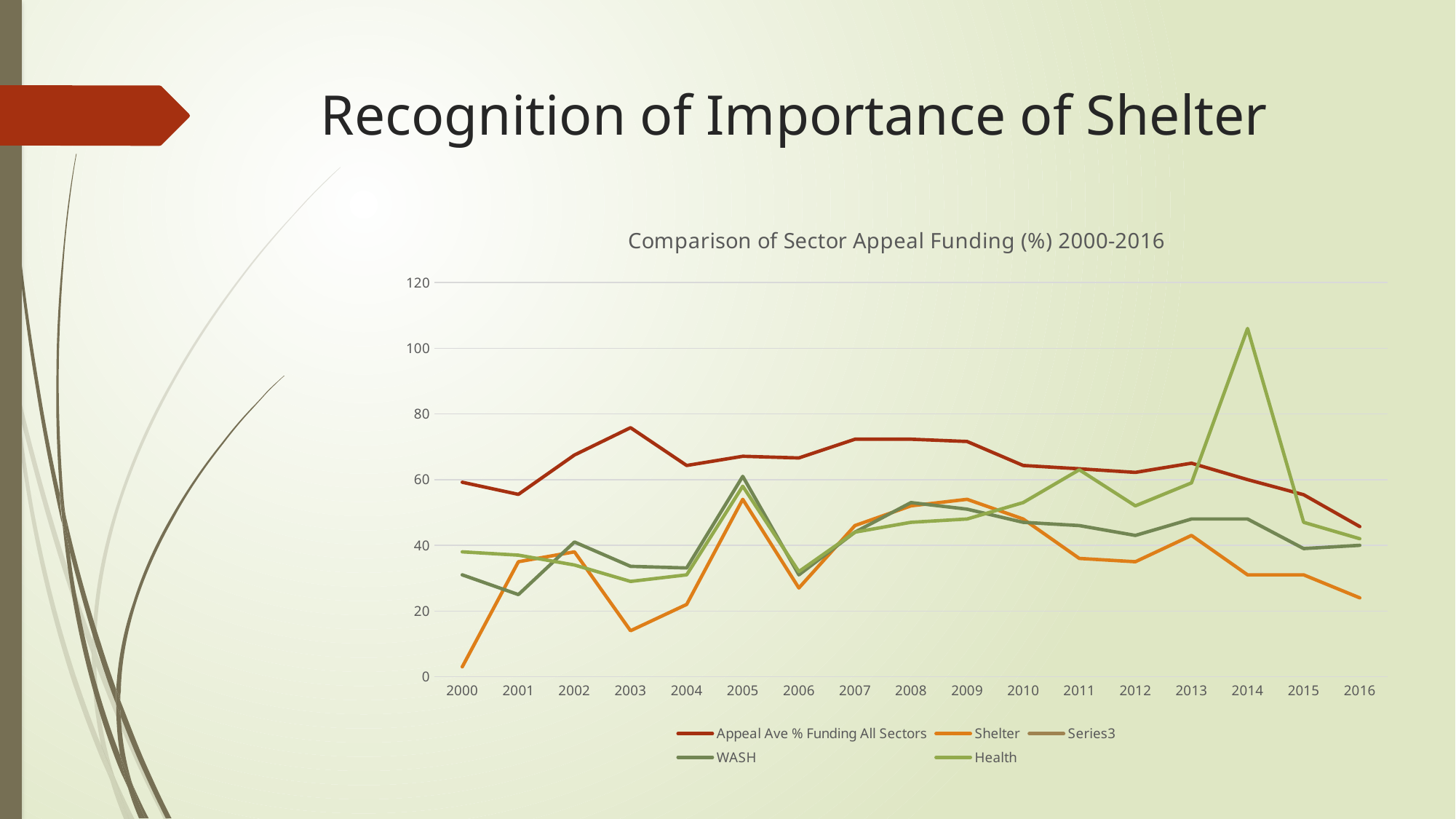
Is the value for Appeal Ave % Funding All Sectors in 2003 greater or less than 60? greater Does the Shelter series rise or fall from 2013 to 2016? fall Is the value for Shelter in 2000 greater or less than 20? less Is the value for Shelter in 2016 greater or less than 40? less What kind of chart is shown on the slide? line chart In which year does the Shelter series have its lowest value? 2000 What is the title of the chart? Comparison of Sector Appeal Funding (%) 2000-2016 How many years are plotted along the x axis? 17 In 2014, which is larger: the value for Health or the value for Shelter? Health How many series does the legend list? 5 In which year does the Health series reach its highest value? 2014